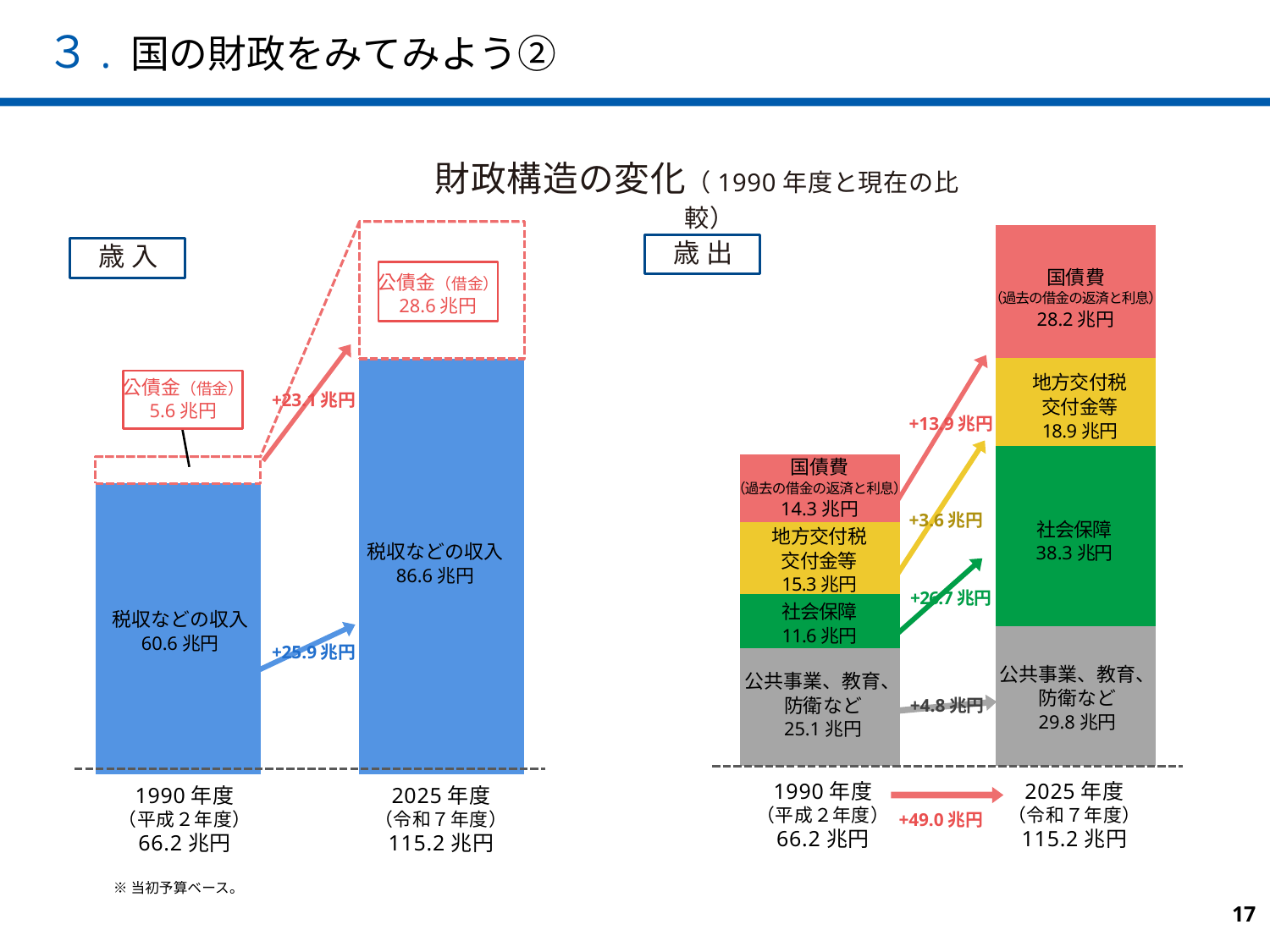
歳出のグラフで、2025年度の「社会保障」はいくらですか？ 38.3兆円 歳入のグラフで、2025年度の「税収などの収入」はいくらですか？ 86.6兆円 歳出のグラフで、1990年度の「地方交付税交付金等」はいくらですか？ 15.3兆円 歳入のグラフで、2025年度の歳入合計はいくらですか？ 115.2兆円 歳出のグラフで、1990年度に最も小さい項目はどれですか？ 社会保障 歳出のグラフは何種類のグラフですか？ 積み上げ棒グラフ 歳入のグラフで、1990年度の「公債金（借金）」はいくらですか？ 5.6兆円 歳出のグラフで、1990年度の歳出合計はいくらですか？ 66.2兆円 歳入のグラフで、1990年度から2025年度にかけて「公債金（借金）」はいくら増えましたか？ 23.1兆円 歳出のグラフで、2025年度の「国債費」と「地方交付税交付金等」ではどちらが大きいですか？ 国債費 歳出のグラフで、1990年度から2025年度にかけて「社会保障」はいくら増えましたか？ 26.7兆円 歳出のグラフで、2025年度に最も大きい項目はどれですか？ 社会保障